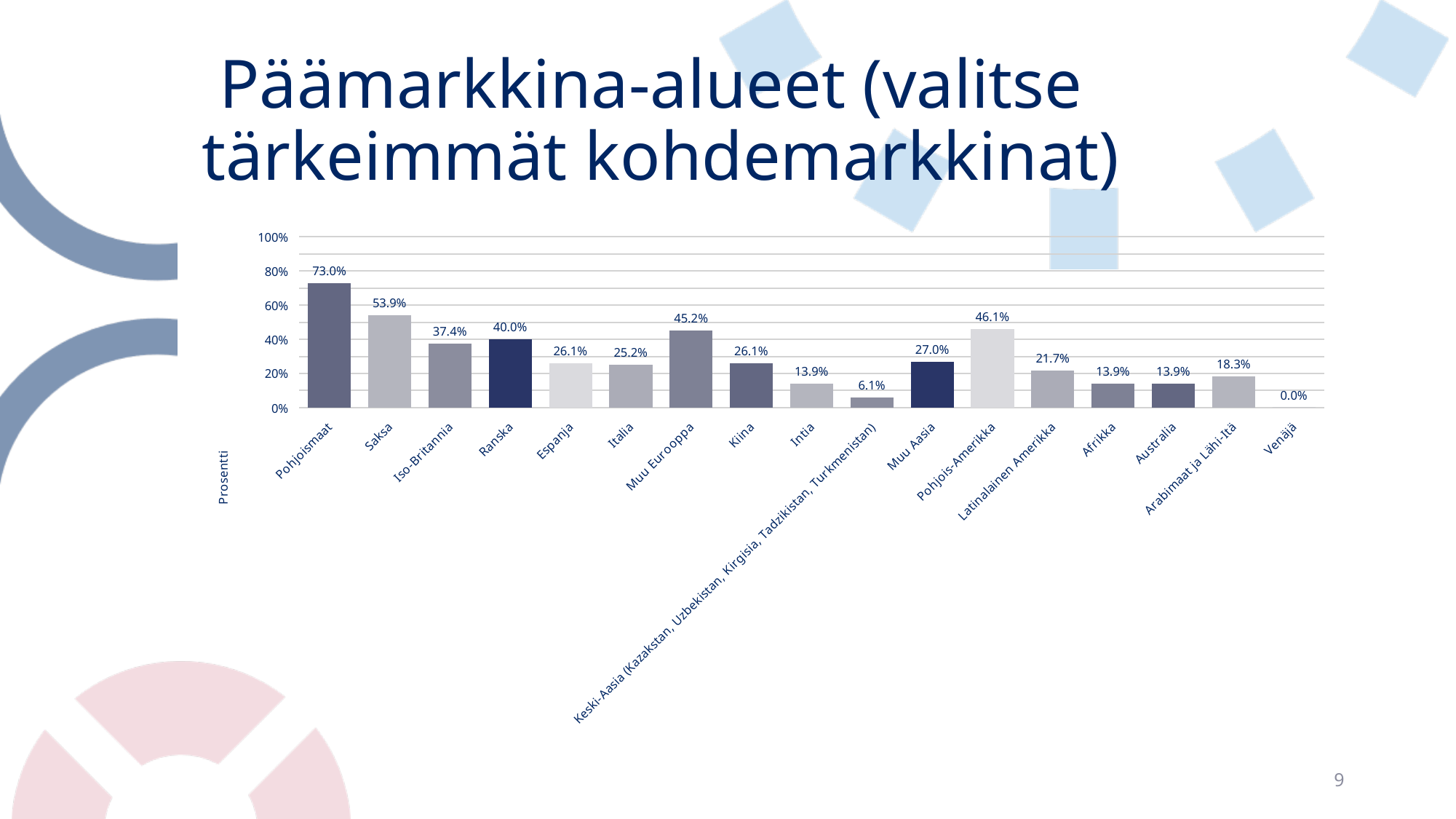
What is the value for Pohjoismaat? 73.0% What is the difference between the values for Saksa and Ranska? 13.9% Which is larger, the value for Pohjois-Amerikka or the value for Muu Aasia? Pohjois-Amerikka Is the value for Iso-Britannia greater or less than 40%? less What is the value for Keski-Aasia (Kazakstan, Uzbekistan, Kirgisia, Tadzikistan, Turkmenistan)? 6.1% What is the value for Muu Eurooppa? 45.2% What is the value for Latinalainen Amerikka? 21.7% Which category has the lowest value? Venäjä How many categories are shown on the x axis? 17 What is the label of the vertical axis? Prosentti Which category has the highest value? Pohjoismaat What kind of chart is shown on the slide? bar chart